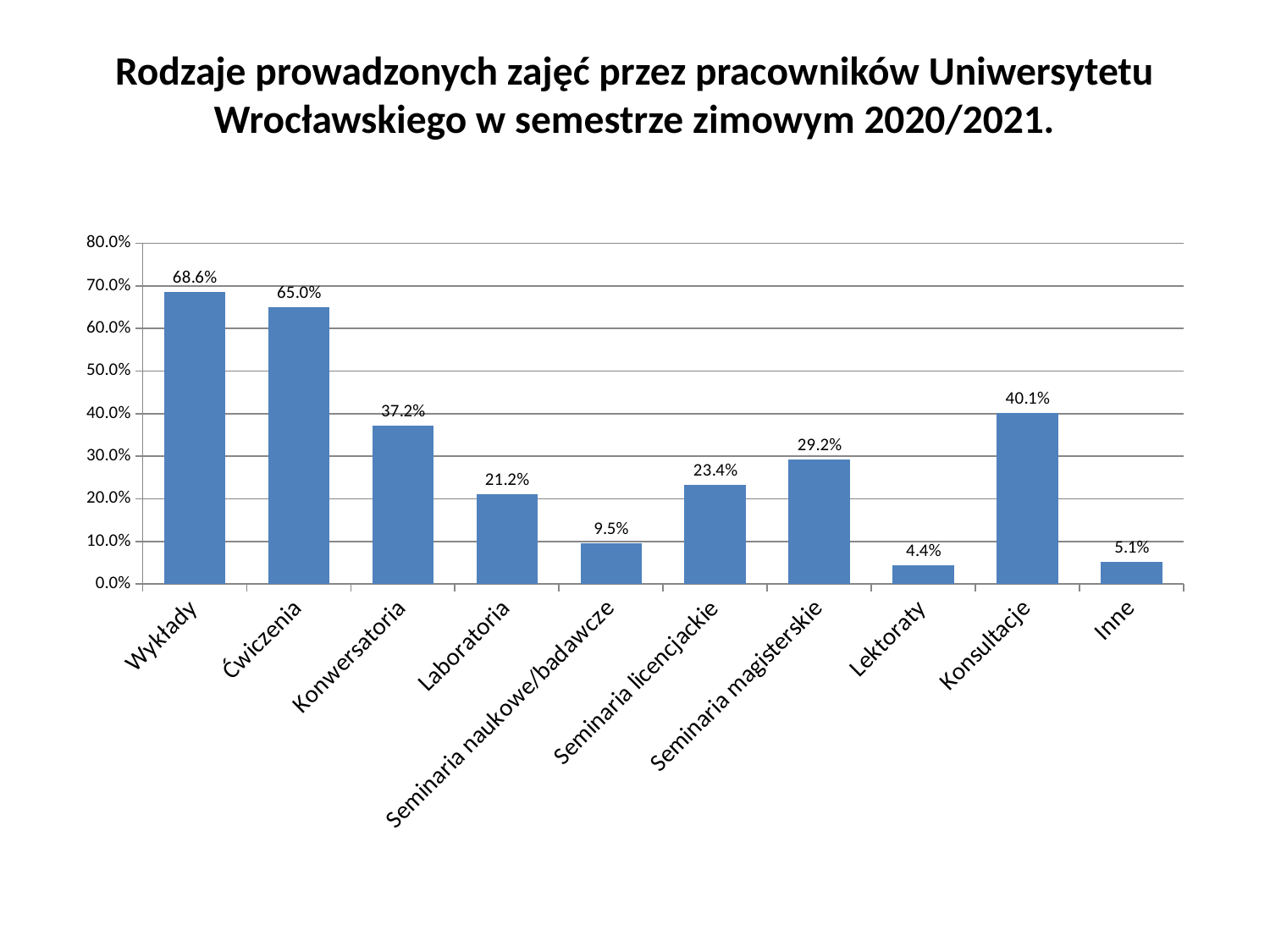
What is the difference between the values for Seminaria magisterskie and Seminaria licencjackie? 5.8% What is the title of the chart? Rodzaje prowadzonych zajęć przez pracowników Uniwersytetu Wrocławskiego w semestrze zimowym 2020/2021. Which category has the lowest value? Lektoraty What kind of chart is shown on the slide? bar chart What is the difference between the values for Wykłady and Ćwiczenia? 3.6% What is the value for Seminaria naukowe/badawcze? 9.5% What is the value for Konsultacje? 40.1% What is the value for Wykłady? 68.6% Which is larger, the value for Konwersatoria or the value for Konsultacje? Konsultacje How many categories are shown on the x axis? 10 Which category has the highest value? Wykłady Is the value for Laboratoria greater or less than 30.0%? less